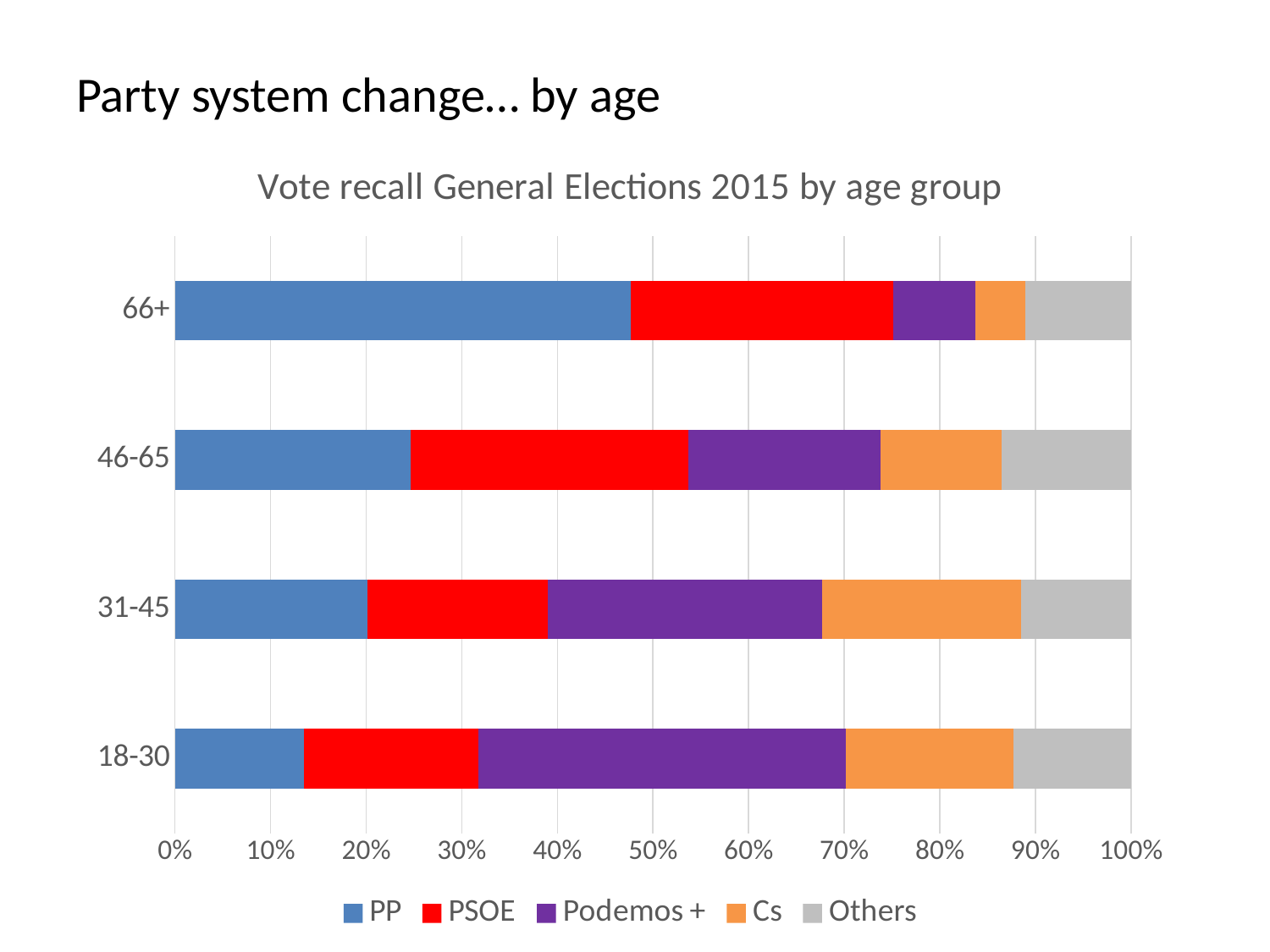
In the 18-30 age group, which is larger, the Podemos + share or the PSOE share? Podemos + Which age group has the largest PP share? 66+ Which age group has the smallest PP share? 18-30 Which party is shown in purple in the legend? Podemos + Is the PP share for the 18-30 age group greater or less than 20%? less How many series does the legend list? 5 What kind of chart is shown on the slide? Bar chart Which age group has the largest Podemos + share? 18-30 How many age groups are shown on the chart? 4 What is the title of the chart? Vote recall General Elections 2015 by age group Is the PP share for the 66+ age group greater or less than 40%? greater In the 66+ age group, which is larger, the PP share or the PSOE share? PP